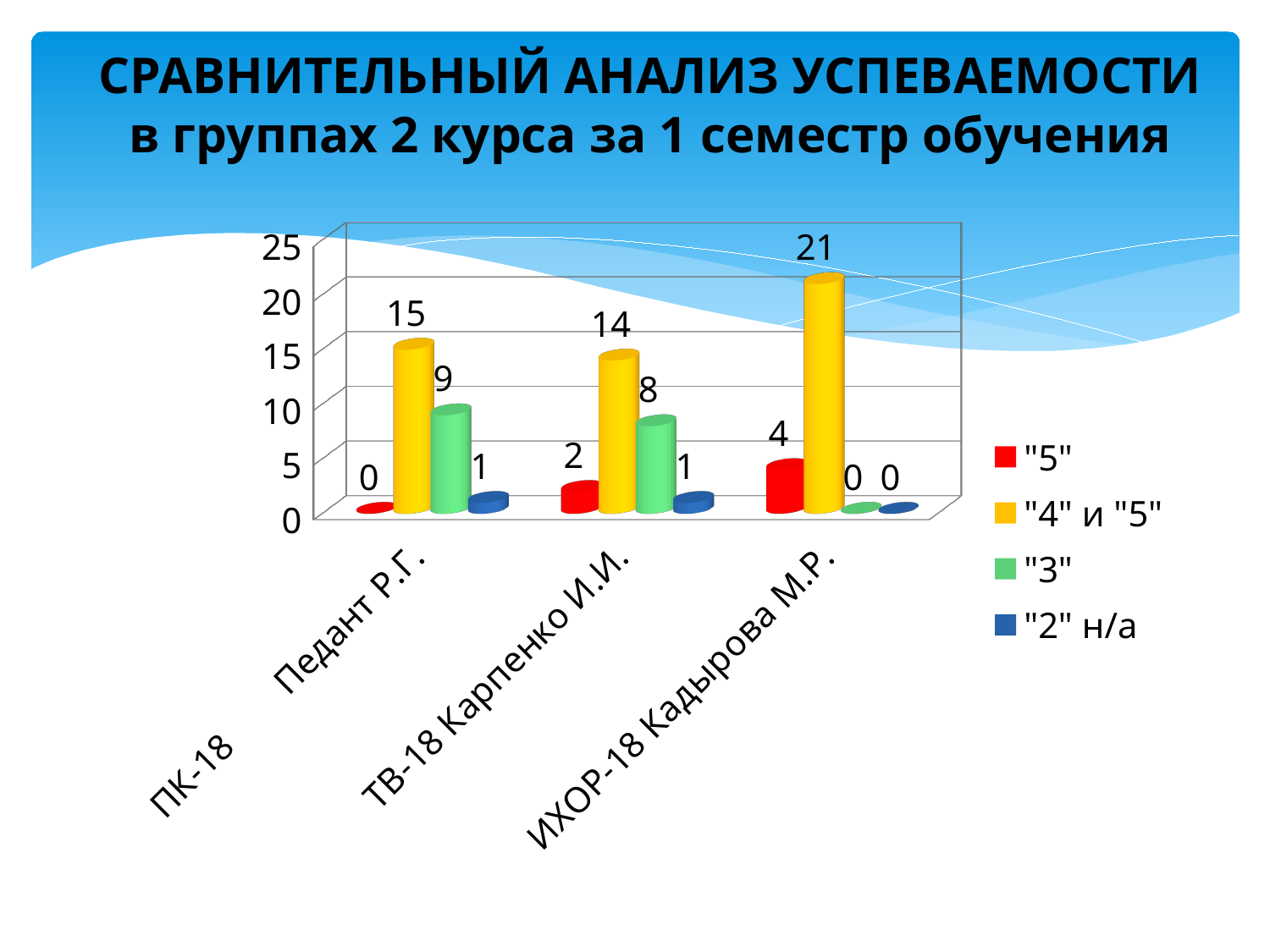
What is the value of the "2" н/а series for ИХОР-18 Кадырова М.Р.? 0 Which group has the lowest value in the "5" series? ПК-18 Педант Р.Г. How many series does the legend list? 4 Which group has the highest value in the "4" и "5" series? ИХОР-18 Кадырова М.Р. What is the value of the "4" и "5" series for ИХОР-18 Кадырова М.Р.? 21 What kind of chart is shown on the slide? Bar chart What is the difference between the "4" и "5" values for ИХОР-18 Кадырова М.Р. and ТВ-18 Карпенко И.И.? 7 Which colour represents the "2" н/а series in the legend? Blue How many groups (categories) are shown on the x axis? 3 What is the value of the "3" series for ПК-18 Педант Р.Г.? 9 Which is larger: the "3" value for ПК-18 Педант Р.Г. or for ТВ-18 Карпенко И.И.? ПК-18 Педант Р.Г. What is the value of the "5" series for ТВ-18 Карпенко И.И.? 2